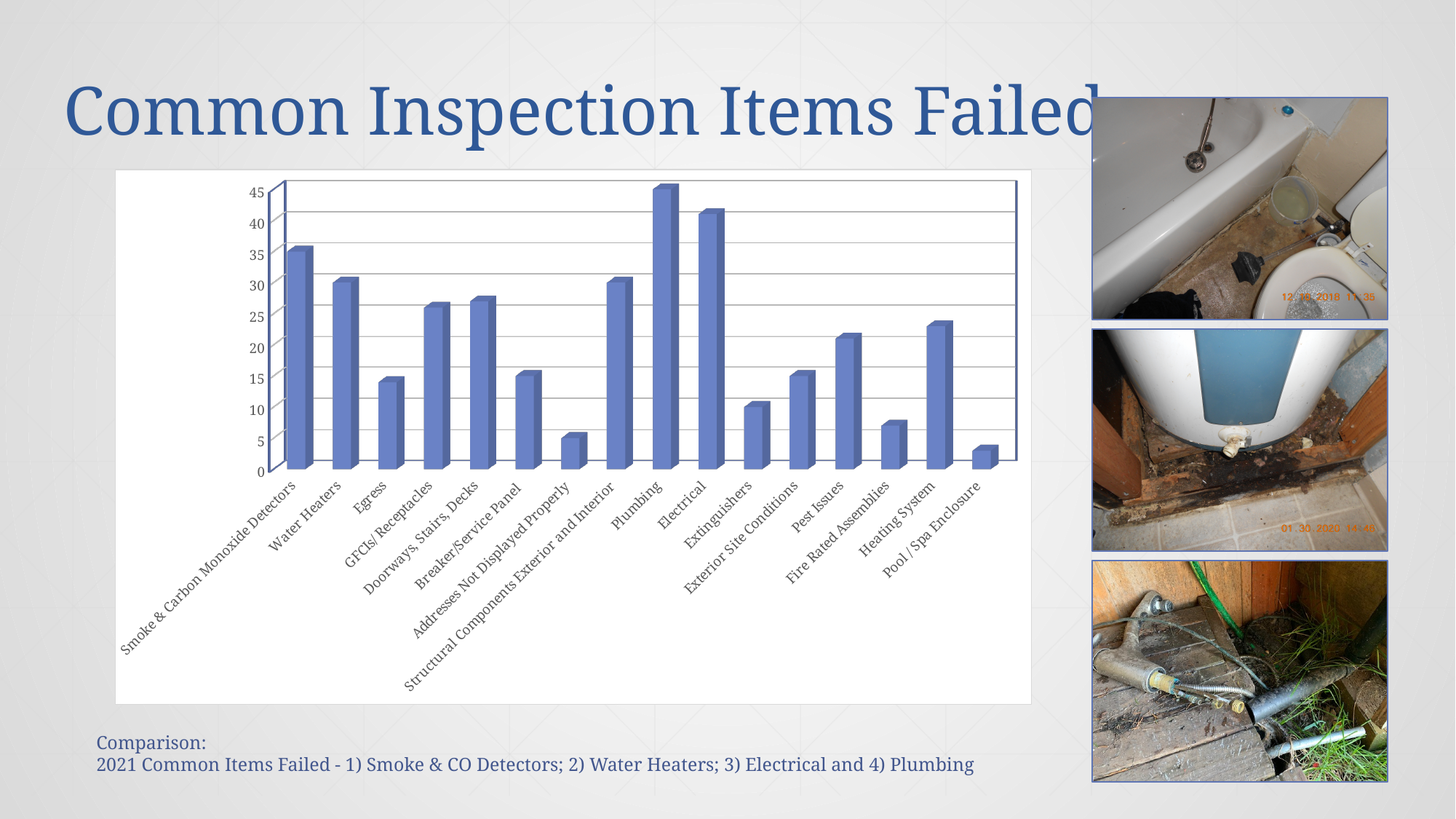
How many categories are plotted on the chart? 16 Is the value for Addresses Not Displayed Properly greater or less than 10? less Which category has the highest value on the chart? Plumbing Which category has the lowest value on the chart? Pool / Spa Enclosure Is the value for Smoke & Carbon Monoxide Detectors greater or less than 30? greater Is the value for Egress greater or less than 20? less What kind of chart is shown on the slide? bar chart Which is larger, the value for Pest Issues or the value for Fire Rated Assemblies? Pest Issues Which is larger, the value for Electrical or the value for Water Heaters? Electrical What is the highest value shown on the chart's vertical axis? 45